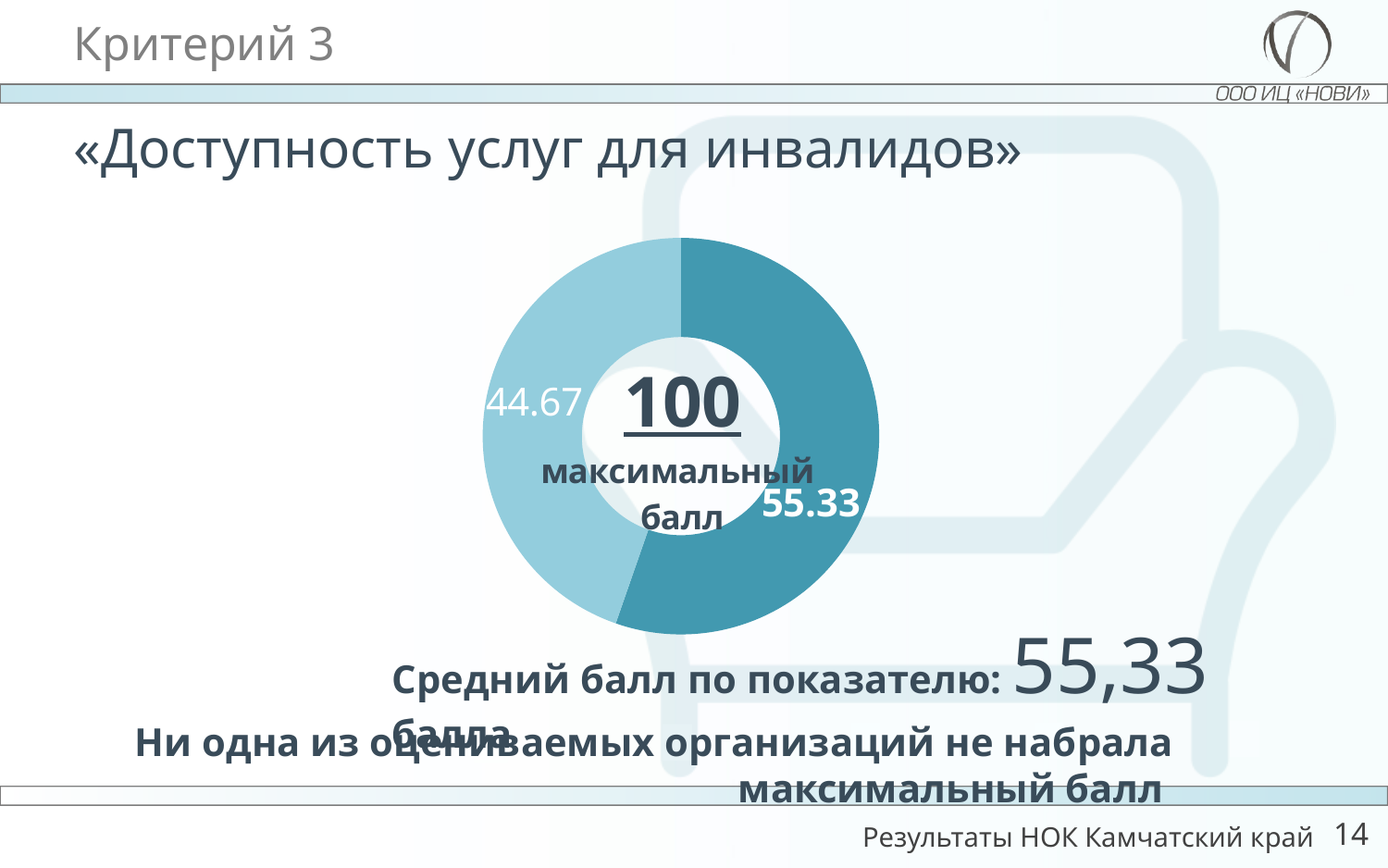
What is the difference between the two slice values on the donut chart? 10.66 How many slices does the donut chart have? 2 What text accompanies the number in the centre of the donut chart? максимальный балл What value is printed on the lighter blue slice of the donut chart? 44.67 What kind of chart is shown on the slide? Pie chart (donut) What value is printed on the darker teal slice of the donut chart? 55.33 Which slice of the donut chart is larger, the darker teal one or the lighter blue one? The darker teal one (55.33) What is the smallest value shown on the donut chart? 44.67 What number is printed in the centre of the donut chart? 100 What share of the whole donut does the darker teal slice (55.33) represent? 55.33% What is the largest value shown on the donut chart? 55.33 What is the total of the two slice values on the donut chart? 100